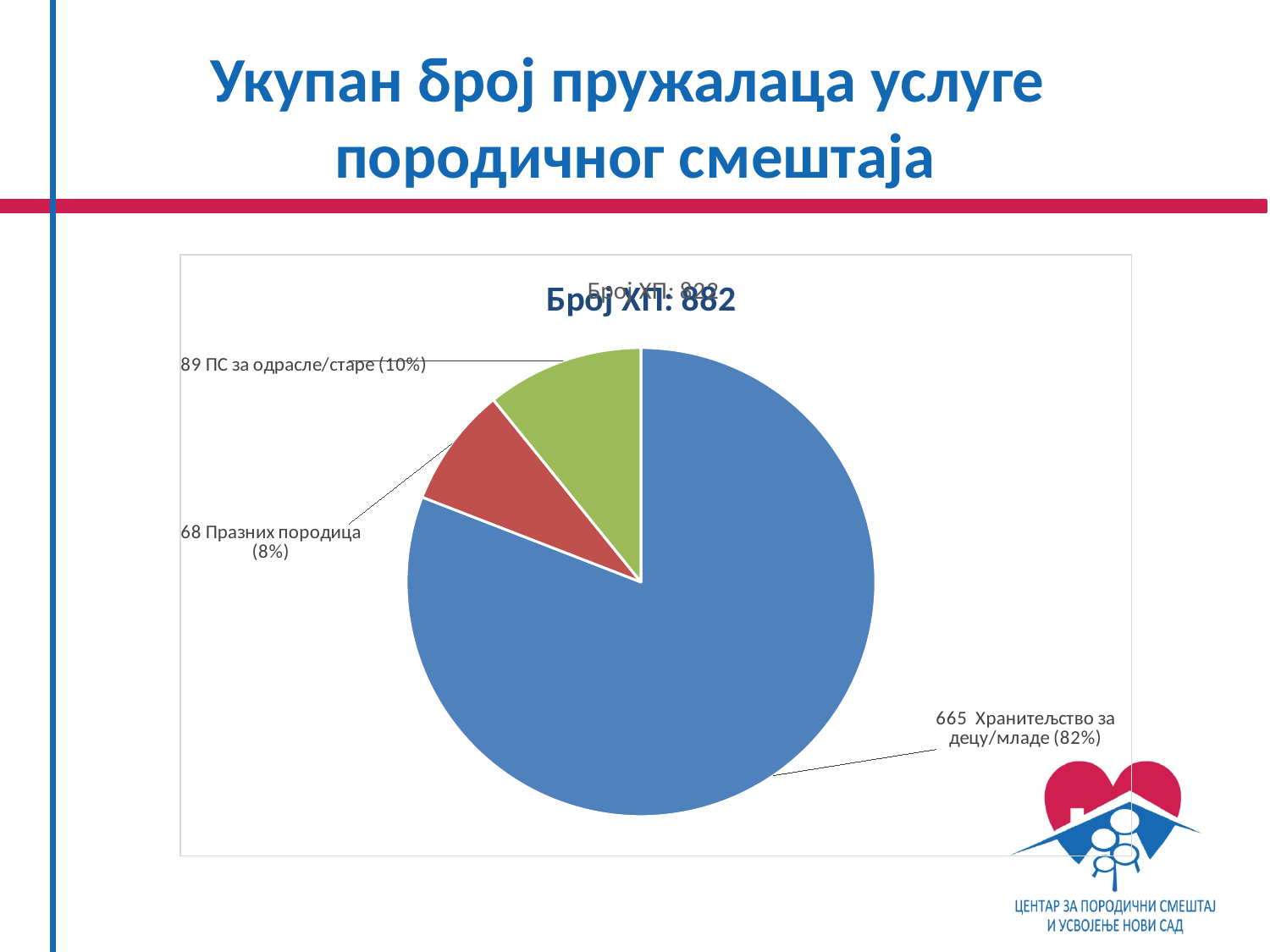
What kind of chart is shown on the slide? pie chart How many slices does the pie chart have? 3 What is the value for Хранитељство за децу/младе? 665 What is the value for Празних породица? 68 What is the difference between the values for ПС за одрасле/старе and Празних породица? 21 Which category has the largest slice? Хранитељство за децу/младе What share of the pie does ПС за одрасле/старе represent? 10% What share of the pie does Хранитељство за децу/младе represent? 82% What share of the pie does Празних породица represent? 8% Which category has the smallest slice? Празних породица What is the value for ПС за одрасле/старе? 89